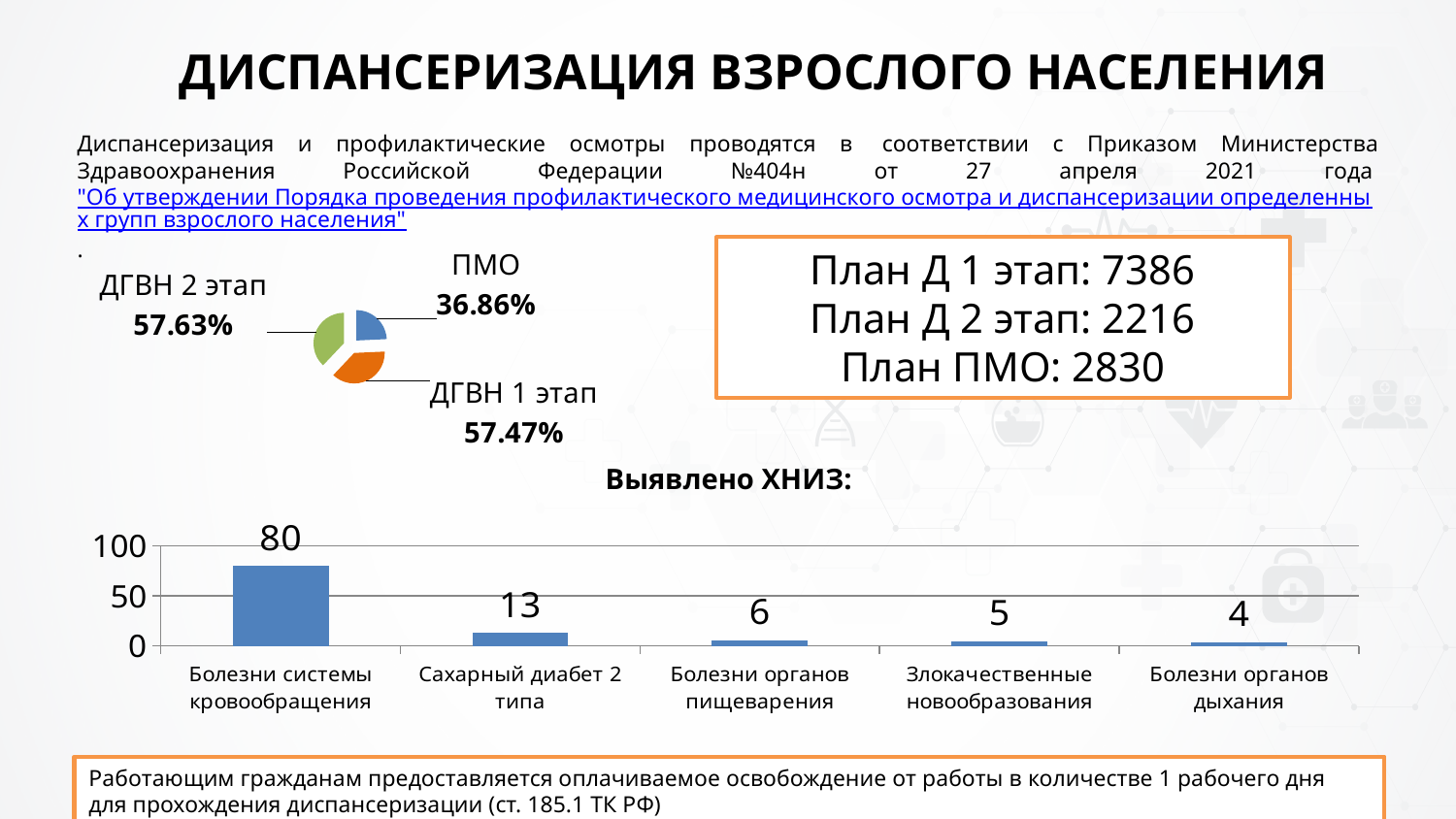
In the pie chart at the top left, what is the value shown for 'ПМО'? 36.86% In the bar chart 'Выявлено ХНИЗ', what is the value for 'Болезни системы кровообращения'? 80 In the bar chart 'Выявлено ХНИЗ', how many categories are shown? 5 In the bar chart 'Выявлено ХНИЗ', what is the value for 'Сахарный диабет 2 типа'? 13 In the bar chart 'Выявлено ХНИЗ', which is larger: 'Болезни органов пищеварения' or 'Злокачественные новообразования'? Болезни органов пищеварения In the bar chart 'Выявлено ХНИЗ', what is the value for 'Болезни органов дыхания'? 4 In the bar chart 'Выявлено ХНИЗ', what is the difference between 'Болезни системы кровообращения' and 'Сахарный диабет 2 типа'? 67 In the pie chart at the top left, what is the value shown for 'ДГВН 2 этап'? 57.63% In the pie chart at the top left, what is the value shown for 'ДГВН 1 этап'? 57.47% In the bar chart 'Выявлено ХНИЗ', which category has the lowest value? Болезни органов дыхания What type of chart is the 'Выявлено ХНИЗ' chart? bar chart In the bar chart 'Выявлено ХНИЗ', which category has the highest value? Болезни системы кровообращения